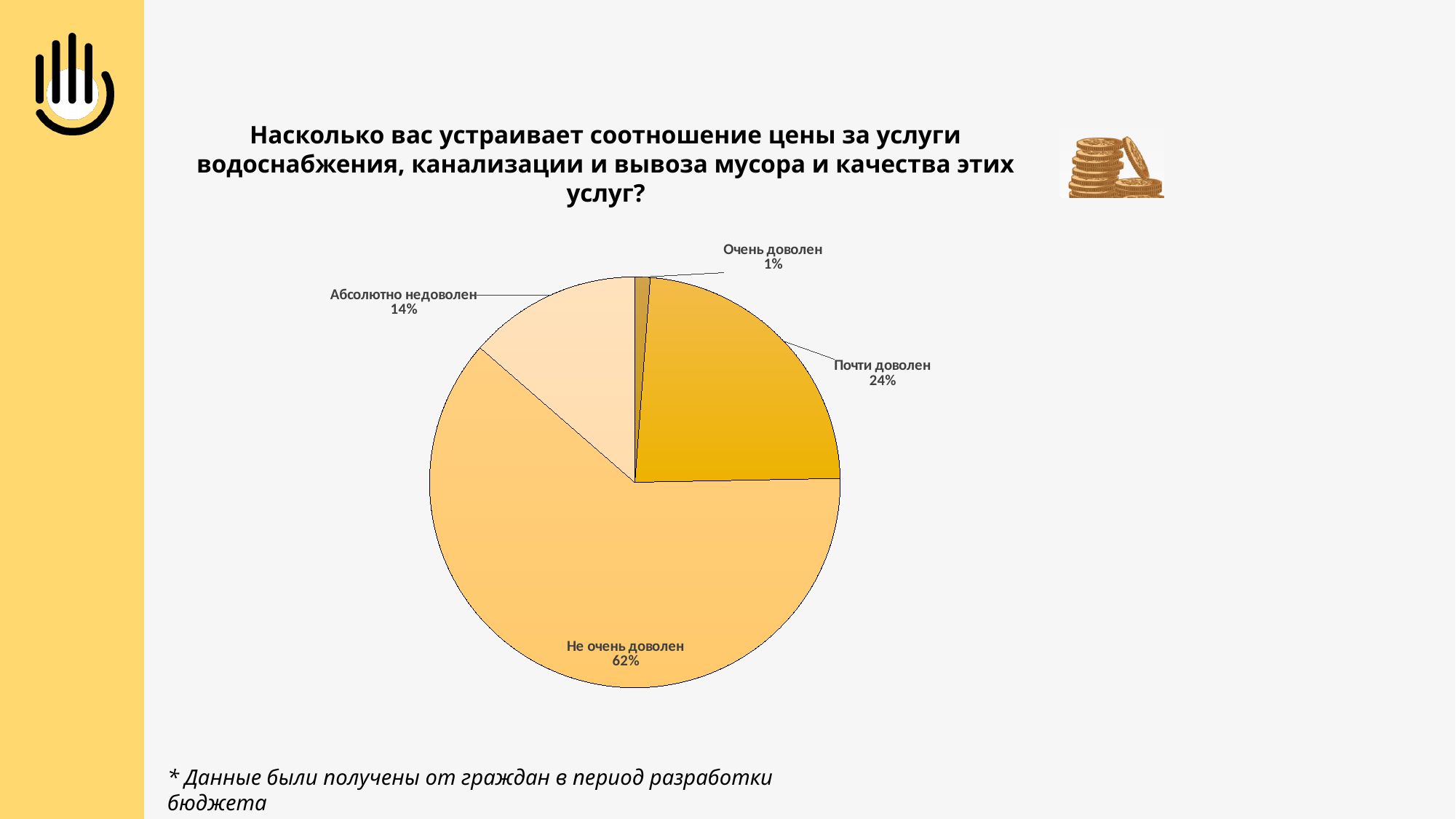
What share of respondents answered "Очень доволен"? 1% Which is larger: the share for "Почти доволен" or the share for "Абсолютно недоволен"? Почти доволен Which response has the smallest share of the pie? Очень доволен What share of respondents answered "Не очень доволен"? 62% What is the difference in percentage points between "Почти доволен" and "Абсолютно недоволен"? 10 Which response has the largest share of the pie? Не очень доволен What is the difference in percentage points between "Не очень доволен" and "Почти доволен"? 38 What kind of chart is shown on the slide? pie chart How many slices does the pie chart have? 4 What share of respondents answered "Почти доволен"? 24% What share of respondents answered "Абсолютно недоволен"? 14% What is the title of the chart? Насколько вас устраивает соотношение цены за услуги водоснабжения, канализации и вывоза мусора и качества этих услуг?